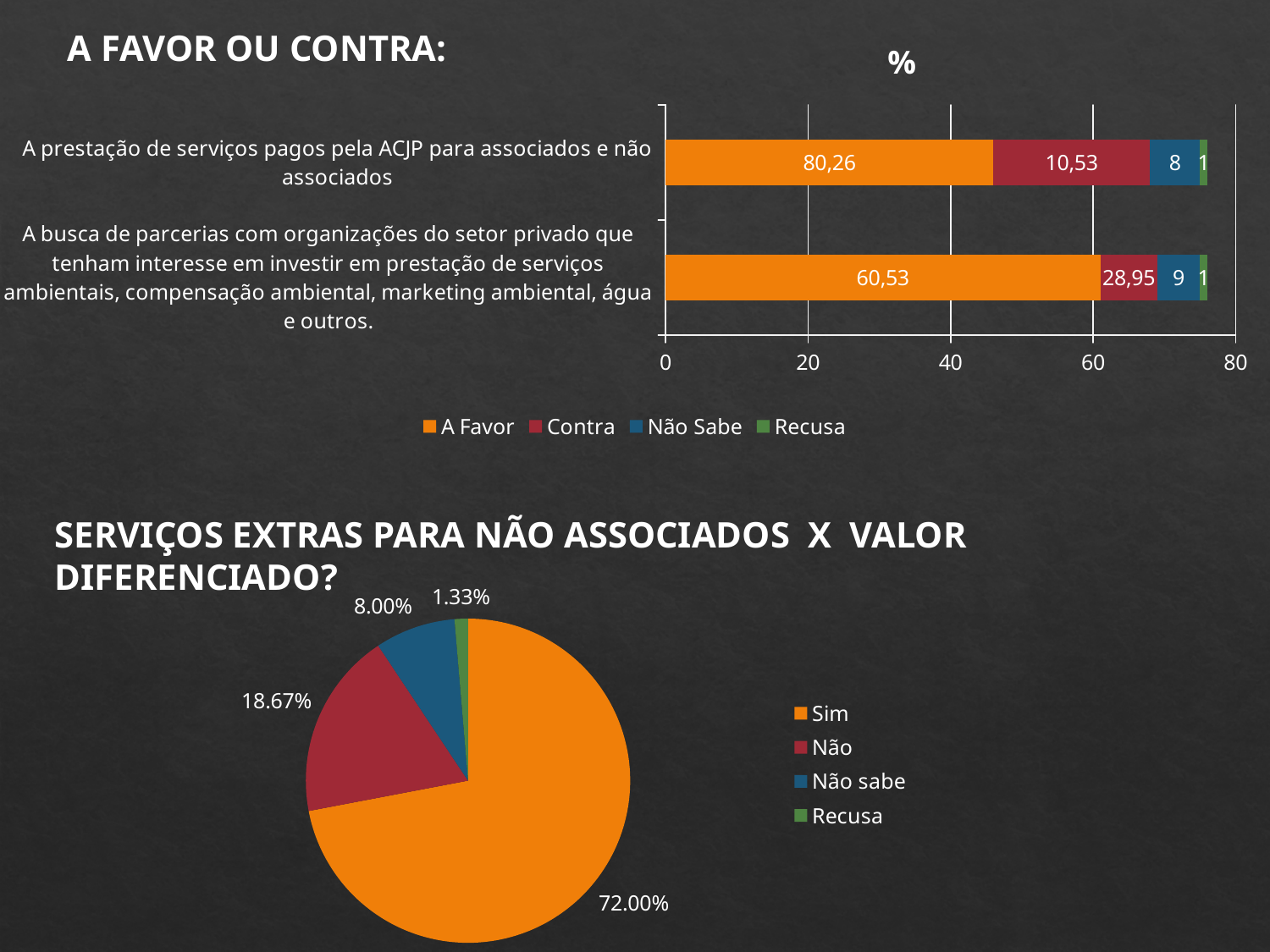
In the top bar chart titled "%", how many categories are plotted? 2 In the top bar chart titled "%", what is the "A Favor" value for "A prestação de serviços pagos pela ACJP para associados e não associados"? 80,26 In the top bar chart titled "%", what is the "Contra" value for the category about "A busca de parcerias com organizações do setor privado"? 28,95 In the bottom pie chart, what share does "Sim" have? 72.00% In the top bar chart titled "%", what is the difference between the "A Favor" values of the two categories? 19,73 In the bottom pie chart, what is the value for "Não sabe"? 8.00% In the bottom pie chart, which slice is the smallest? Recusa What kind of chart is the top chart titled "%"? Stacked bar chart In the bottom pie chart, what is the difference between the "Sim" and "Não" shares? 53.33% In the top bar chart titled "%", how many series does the legend list? 4 In the top bar chart titled "%", what is the "Não Sabe" value for "A prestação de serviços pagos pela ACJP para associados e não associados"? 8